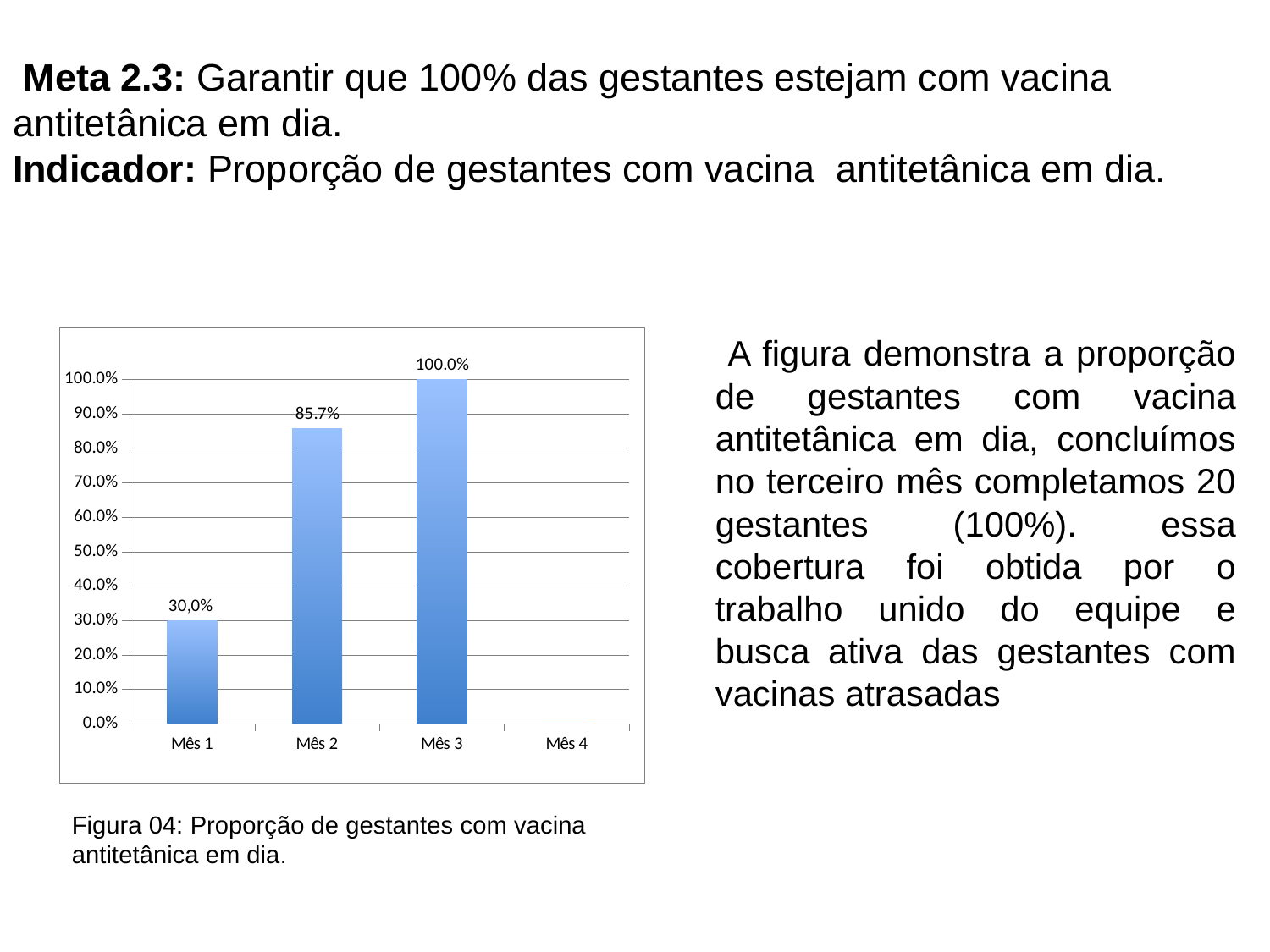
What is the value shown for Mês 3? 100.0% Do the values rise or fall from Mês 1 to Mês 3? rise What is the figure number given in the caption below the chart? Figura 04 Which is larger, the value for Mês 1 or the value for Mês 2? Mês 2 How many month categories are shown on the x axis? 4 Which month has the highest value? Mês 3 What kind of chart is shown on the slide? bar chart What is the value shown for Mês 1? 30,0% Is the value for Mês 2 greater or less than 80.0%? greater What is the difference between the values for Mês 3 and Mês 2? 14.3% What is the value shown for Mês 2? 85.7% Among the months with a plotted bar, which has the lowest value? Mês 1